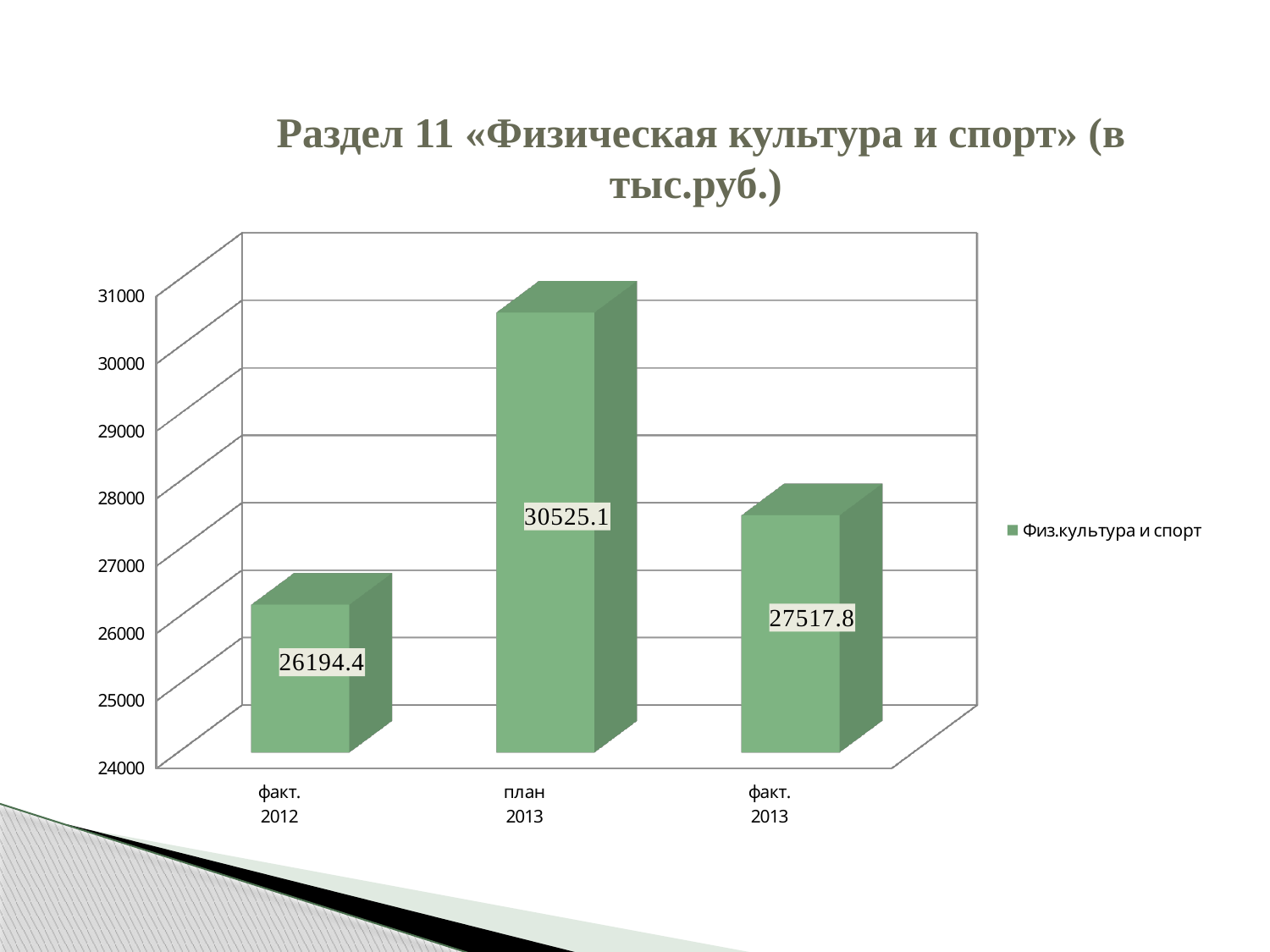
Which is larger, the value for факт. 2013 or the value for факт. 2012? факт. 2013 How many categories are shown on the x axis? 3 What is the difference between the values for факт. 2013 and факт. 2012? 1323.4 Which category has the lowest value? факт. 2012 Which category has the highest value? план 2013 Is the value for план 2013 greater or less than 30000? greater What is the difference between the values for план 2013 and факт. 2013? 3007.3 What series name is listed in the legend? Физ.культура и спорт What kind of chart is shown on the slide? bar chart What is the value for факт. 2013? 27517.8 What is the value for план 2013? 30525.1 What is the value for факт. 2012? 26194.4